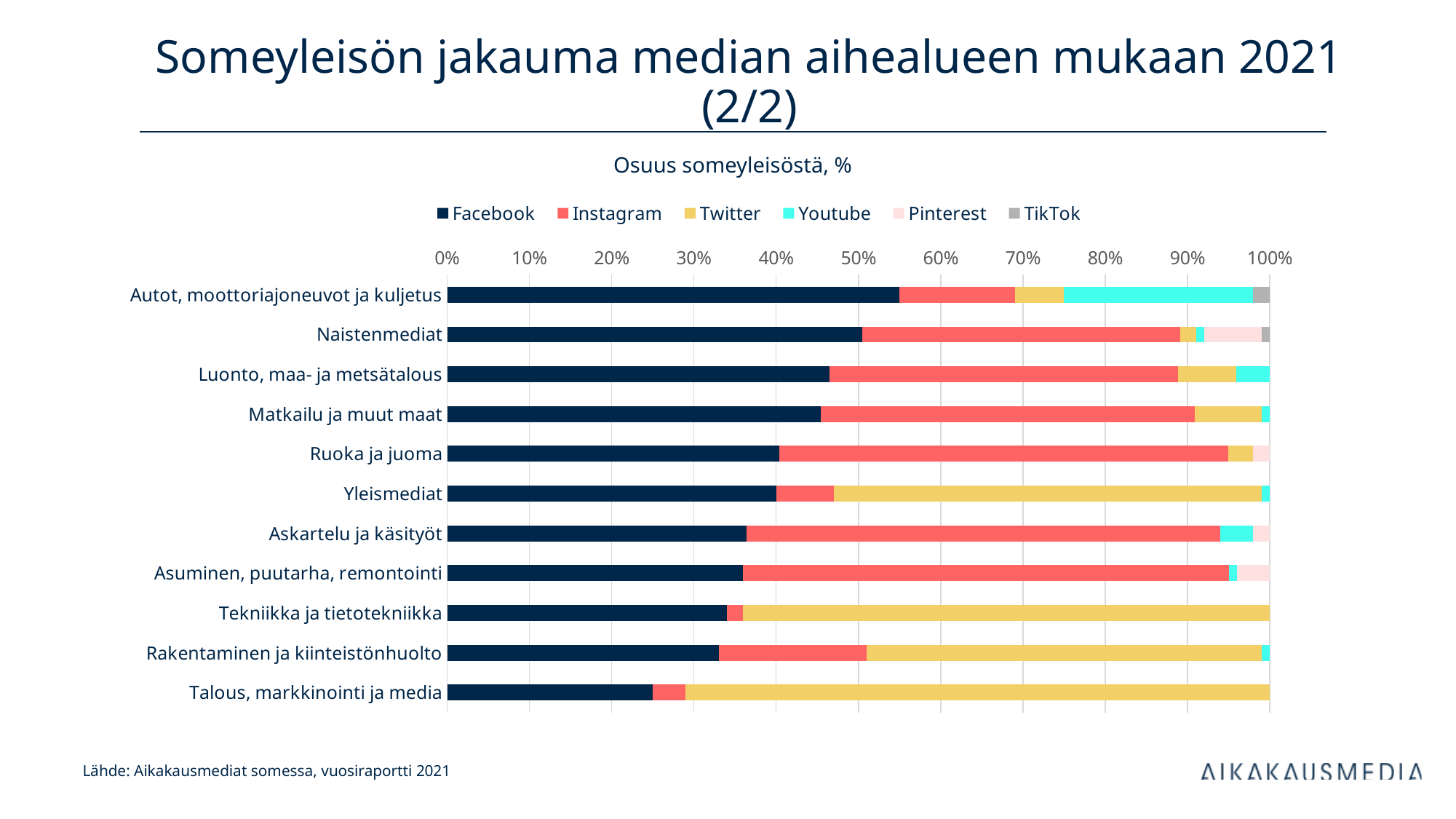
Is the Facebook share for Tekniikka ja tietotekniikka greater or less than 40%? less Is the Facebook share for Autot, moottoriajoneuvot ja kuljetus greater or less than 50%? greater Is the Facebook share for Talous, markkinointi ja media greater or less than 30%? less Which series is shown in dark navy in the legend? Facebook What kind of chart is shown on the slide? stacked bar chart Which has a larger Twitter share: Talous, markkinointi ja media or Rakentaminen ja kiinteistönhuolto? Talous, markkinointi ja media Which category has the smallest Facebook share? Talous, markkinointi ja media What is the axis title shown above the legend? Osuus someyleisöstä, % How many media topic categories are plotted on the chart? 11 Which category has the largest Facebook share? Autot, moottoriajoneuvot ja kuljetus How many series does the legend list? 6 Which category has the largest Youtube share? Autot, moottoriajoneuvot ja kuljetus